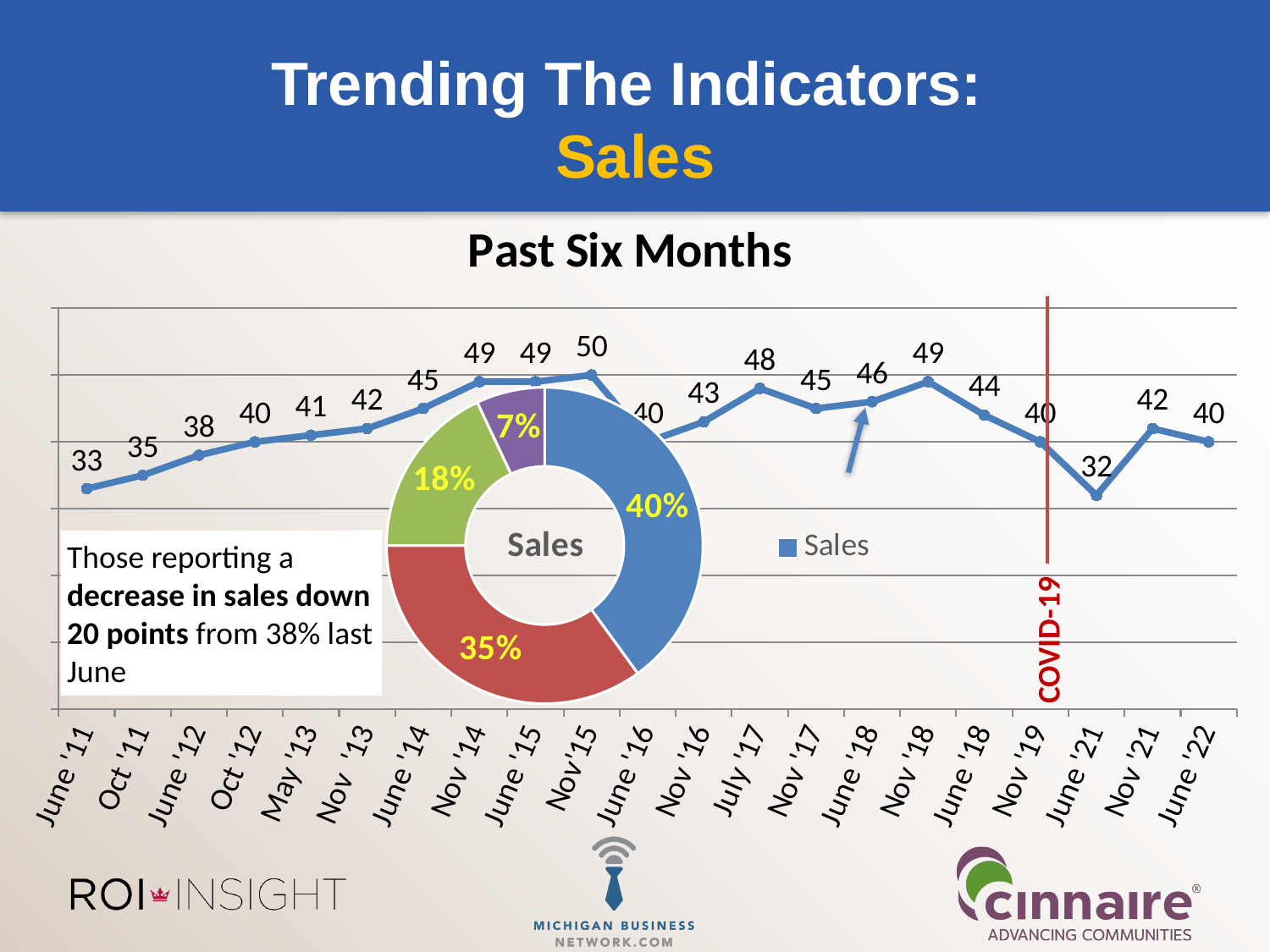
On the donut chart labelled 'Sales' in the middle of the slide, what is the percentage of the largest slice? 40% How many slices does the donut chart labelled 'Sales' have? 4 On the line chart titled 'Past Six Months', what is the value for June '21? 32 On the line chart titled 'Past Six Months', which period has the highest value? Nov '15 On the line chart titled 'Past Six Months', what is the value for June '22? 40 How many data points are plotted on the line chart titled 'Past Six Months'? 21 On the line chart titled 'Past Six Months', which period has the lowest value? June '21 What kind of chart is the 'Past Six Months' chart? Line chart On the line chart titled 'Past Six Months', which is larger, the value for July '17 or the value for Nov '17? July '17 On the line chart titled 'Past Six Months', what is the difference between the values for Nov '21 and June '21? 10 On the line chart titled 'Past Six Months', what is the value for Nov '18? 49